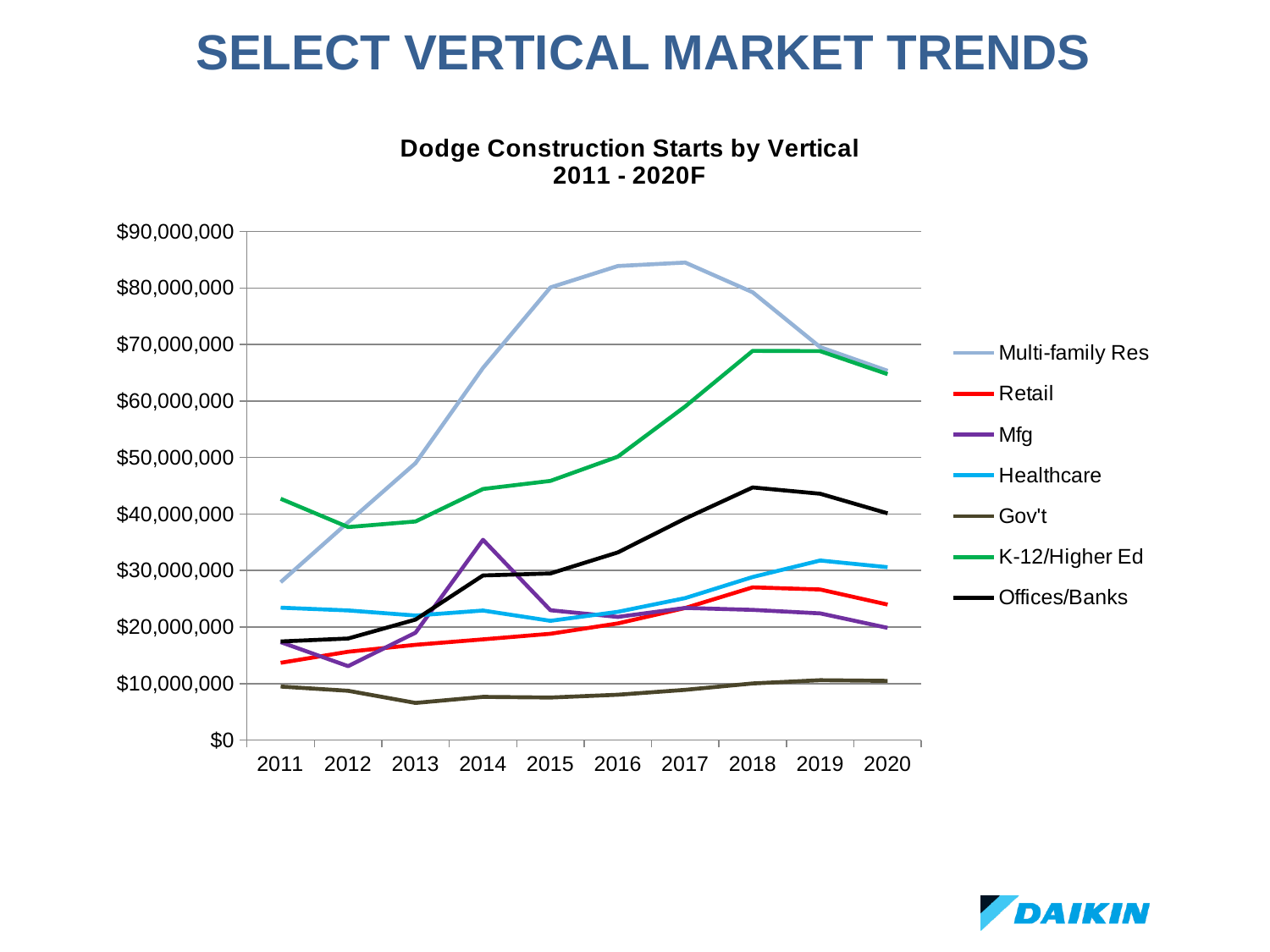
How many series does the legend list? 7 Is the value for Multi-family Res in 2017 greater or less than $80,000,000? greater In 2019, which is larger: Retail or Healthcare? Healthcare What is the title of the chart? Dodge Construction Starts by Vertical 2011 - 2020F Which series has the highest value in 2017? Multi-family Res In 2011, which is larger: K-12/Higher Ed or Multi-family Res? K-12/Higher Ed Is the value for Offices/Banks in 2018 greater or less than $40,000,000? greater What kind of chart is shown on the slide? Line chart Which series has the lowest value in 2020? Gov't How many years are shown on the x axis? 10 Is the value for Gov't in 2013 greater or less than $10,000,000? less Does the Multi-family Res line rise or fall from 2017 to 2020? Fall